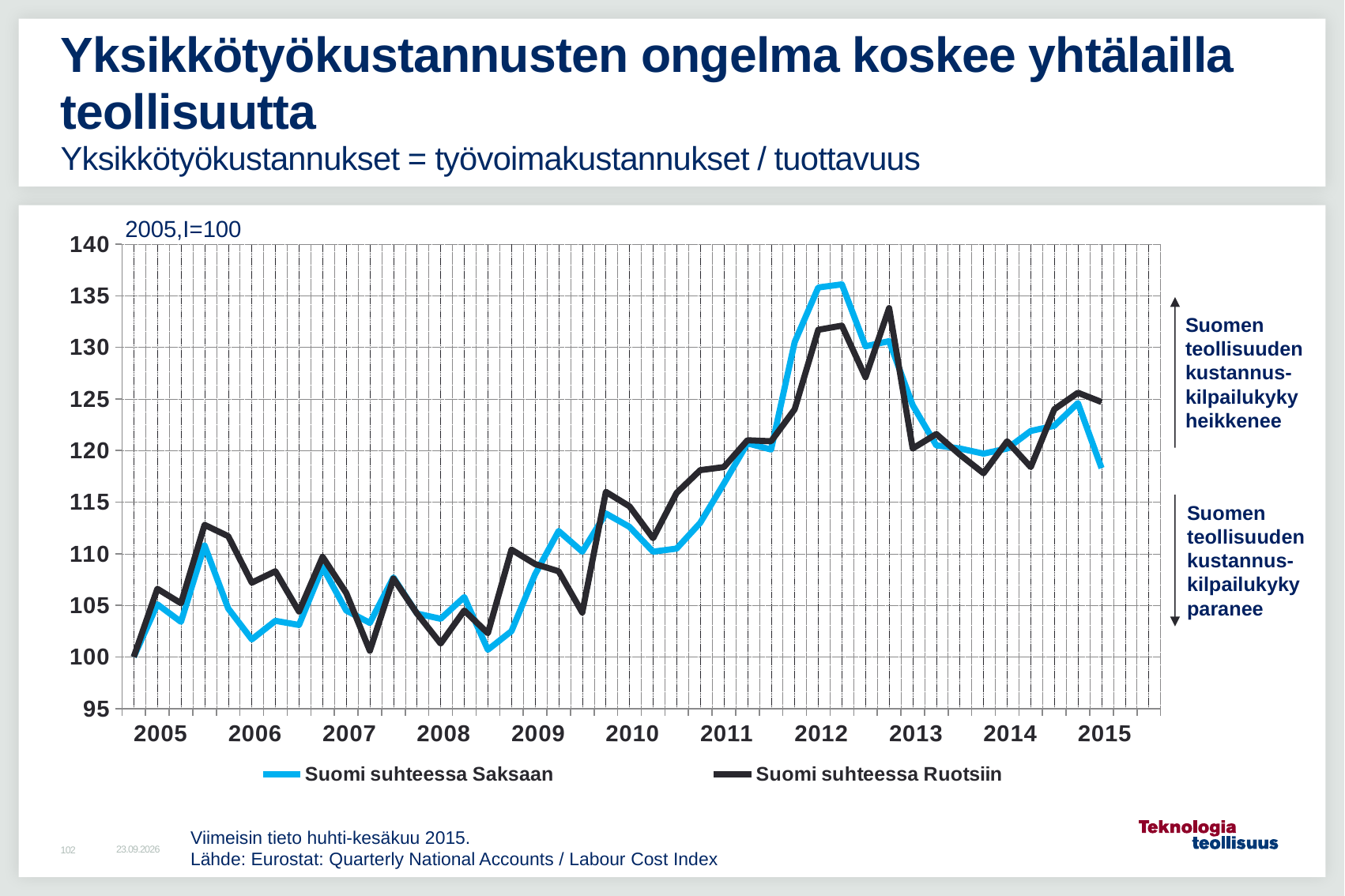
How many years are labelled on the x axis? 11 How many series does the legend list? 2 Is the peak value of Suomi suhteessa Ruotsiin in 2012 greater or less than 130? greater What are the two series named in the legend? Suomi suhteessa Saksaan and Suomi suhteessa Ruotsiin Is the peak value of Suomi suhteessa Saksaan in 2012 greater or less than 130? greater Is the value of Suomi suhteessa Saksaan at the start of 2008 greater or less than 110? less Between 2008 and 2012, do the values of Suomi suhteessa Saksaan generally rise or fall? rise At the last data point in 2015, which series is higher, Suomi suhteessa Saksaan or Suomi suhteessa Ruotsiin? Suomi suhteessa Ruotsiin What kind of chart is shown on the slide? line chart In which year does Suomi suhteessa Saksaan reach its highest value? 2012 At the 2012 peak, which series is higher, Suomi suhteessa Saksaan or Suomi suhteessa Ruotsiin? Suomi suhteessa Saksaan What base year and index value is stated above the chart? 2005, I=100